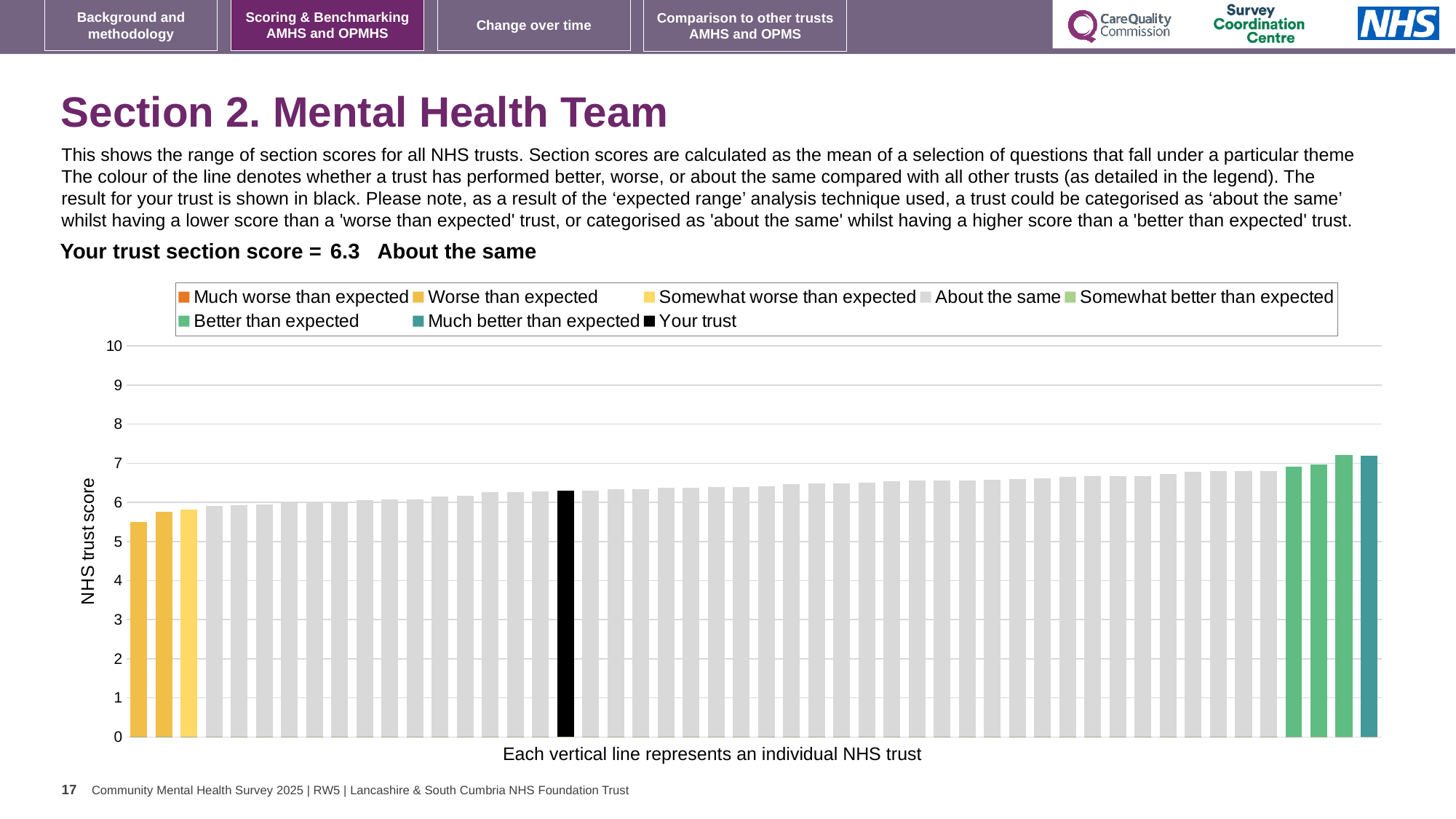
What is the label on the vertical axis of the chart? NHS trust score Which category is your trust's section score placed in? About the same How many bars in the chart are coloured yellow (the 'worse than expected' categories)? 3 What is the section score for your trust shown on the slide? 6.3 Do the bar values rise or fall moving from left to right along the x axis? rise Is the value of the lowest bar in the chart greater or less than 6? less How many entries does the chart legend list? 8 Is the value of the highest bar in the chart greater or less than 8? less How many bars in the chart are coloured green or teal (the 'better than expected' categories)? 4 Is the value of the black 'Your trust' bar greater or less than 6? greater What kind of chart is shown on the slide? bar chart